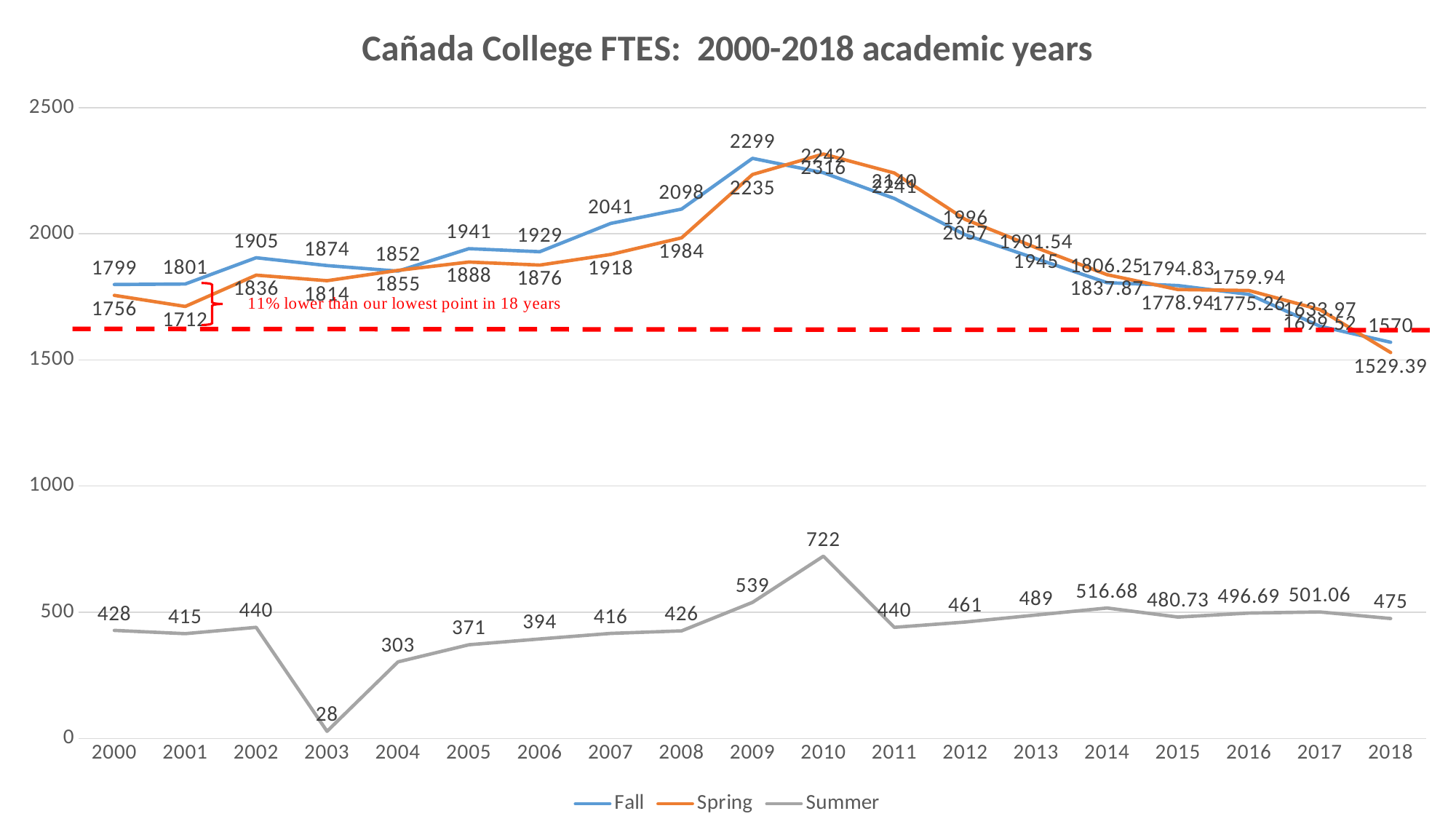
Which is larger in 2002, the Fall or the Spring FTES value? Fall What is the Spring FTES value for 2018? 1529.39 What is the Summer FTES value for 2014? 516.68 What is the difference between the Fall and Spring FTES values in 2000? 43 What is the Summer FTES value for 2010? 722 In which year is the Summer FTES value highest? 2010 What kind of chart is shown on the slide? Line chart In which year is the Summer FTES value lowest? 2003 How many academic years are plotted along the x axis? 19 What is the Fall FTES value for 2009? 2299 How many series does the legend list? 3 Does the Fall FTES value rise or fall from 2013 to 2018? Fall